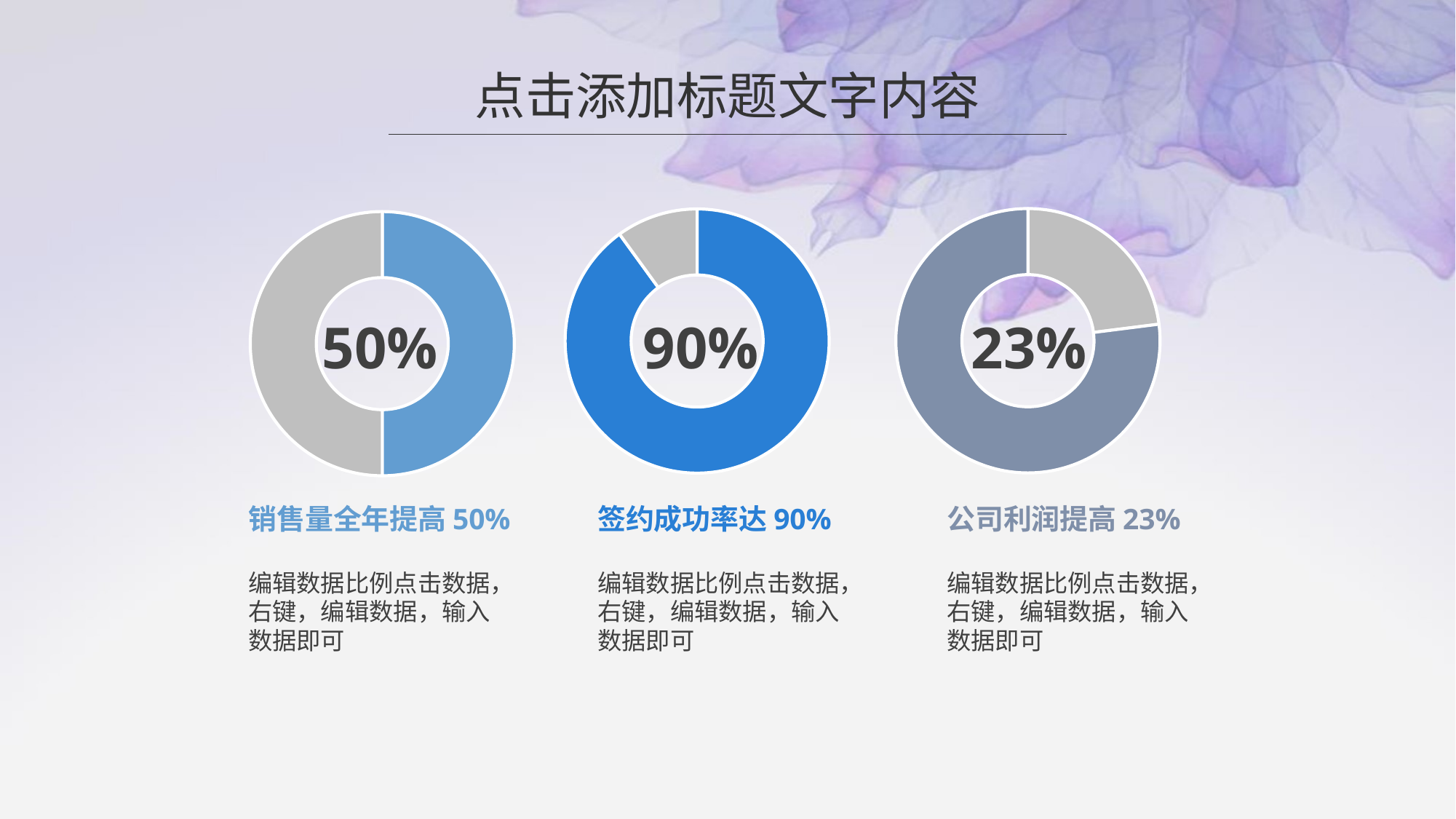
Which of the three donut charts shows the lowest percentage? The right chart (23%) What is the difference between the percentage in the middle chart and the percentage in the left chart? 40% How many donut charts are on the slide? 3 What is the caption under the middle donut chart? 签约成功率达 90% What kind of charts are shown on the slide? Donut (pie) charts What is the difference between the percentage in the left chart and the percentage in the right chart? 27% What percentage is shown in the centre of the right donut chart? 23% Which of the three donut charts shows the highest percentage? The middle chart (90%) What percentage is shown in the centre of the middle donut chart? 90% Is the percentage in the left chart larger or smaller than the percentage in the right chart? Larger What percentage is shown in the centre of the left donut chart? 50% What is the caption under the right donut chart? 公司利润提高 23%